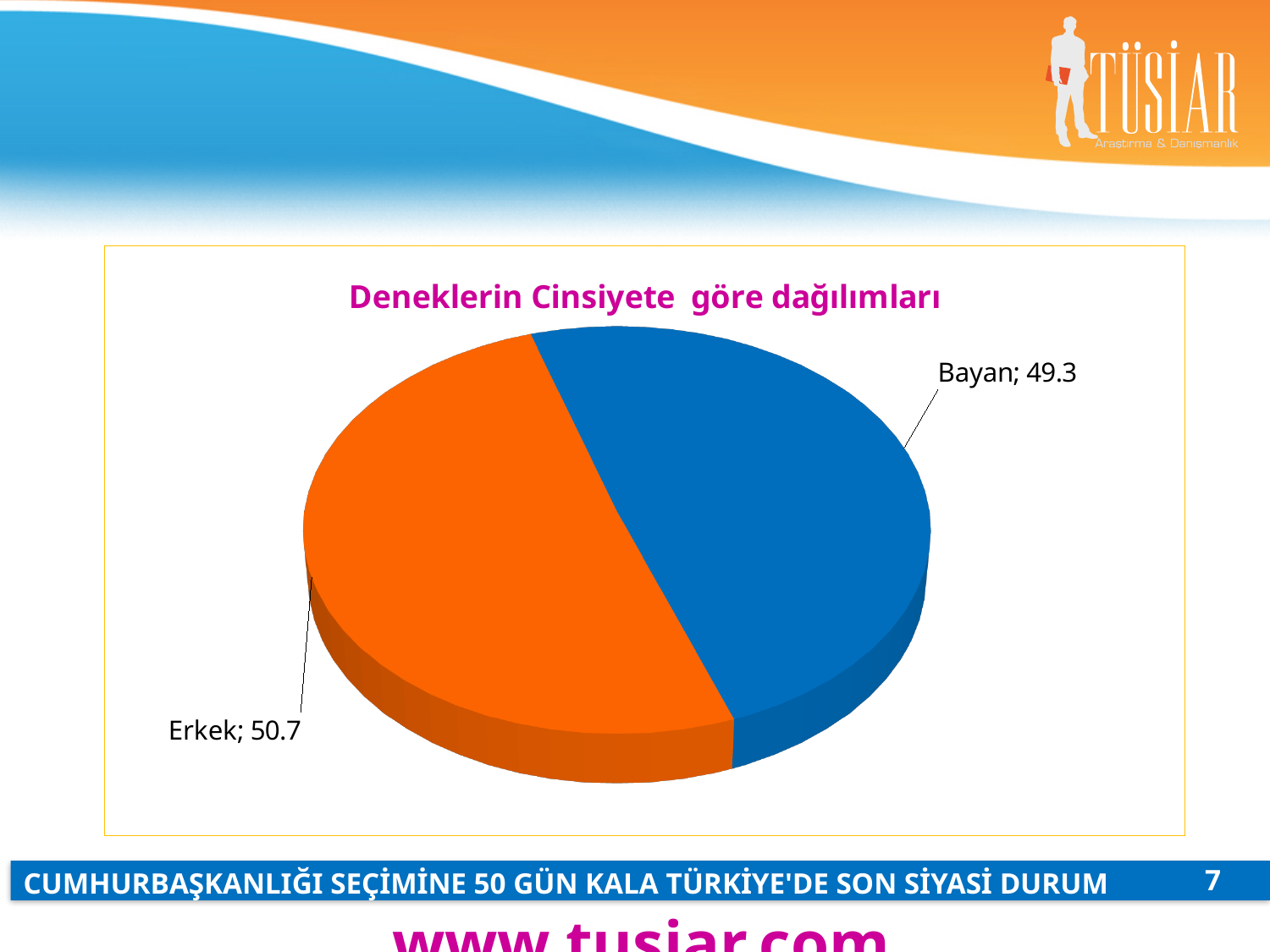
What colour is the Erkek slice? orange Is the value for Erkek larger or smaller than the value for Bayan? larger Which category has the larger share of the pie? Erkek Which category has the smaller share of the pie? Bayan What is the total of the two slice values shown? 100 What is the title of the chart? Deneklerin Cinsiyete göre dağılımları What is the difference between the Erkek and Bayan values? 1.4 What kind of chart is shown on the slide? pie chart How many slices does the pie chart have? 2 What is the value for Erkek in the pie chart? 50.7 What is the value for Bayan in the pie chart? 49.3